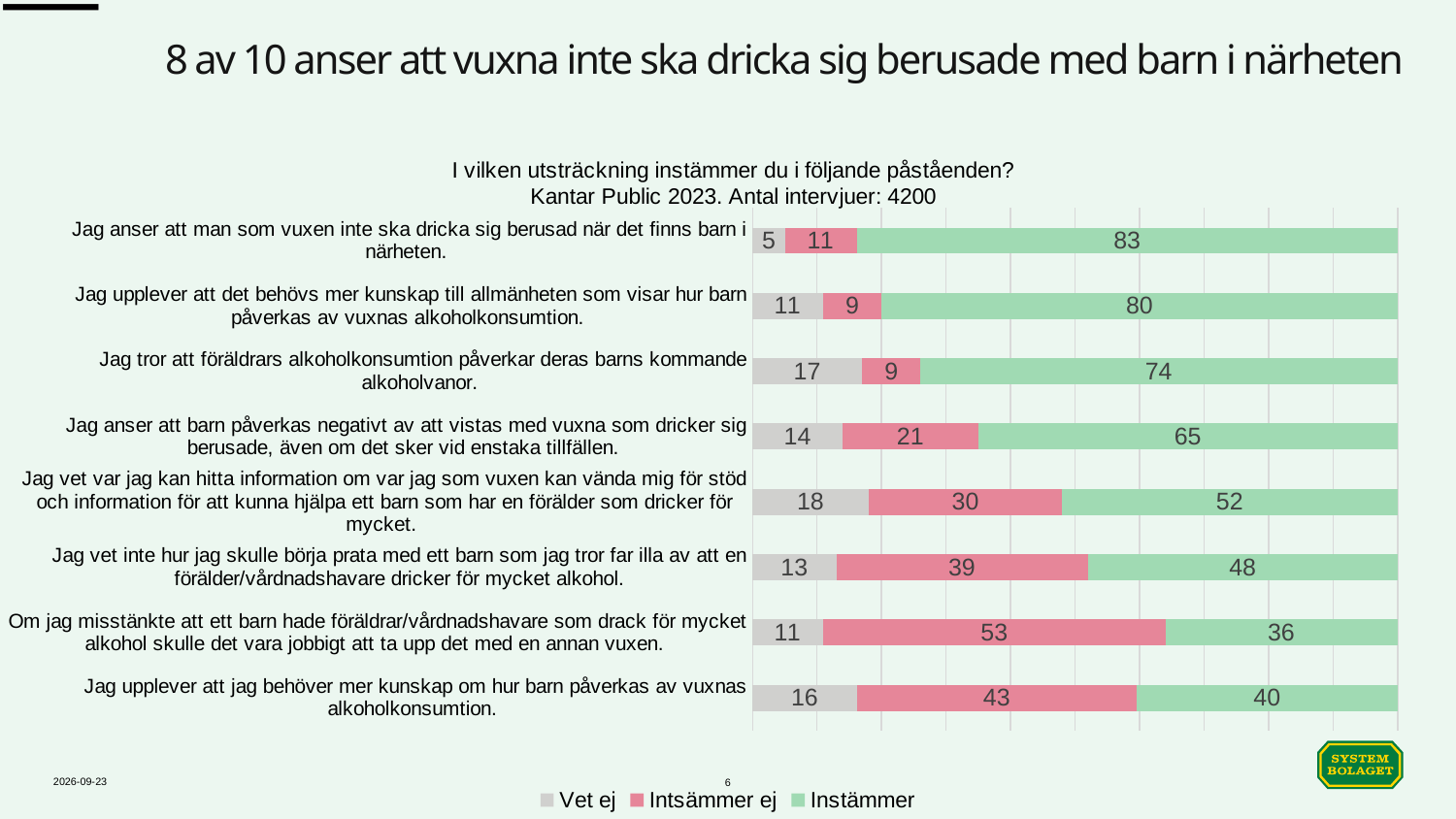
What is the 'Instämmer ej' value for the statement 'Om jag misstänkte att ett barn hade föräldrar/vårdnadshavare som drack för mycket alkohol skulle det vara jobbigt att ta upp det med en annan vuxen'? 53 What is the difference between the 'Instämmer' values for 'Jag upplever att det behövs mer kunskap till allmänheten som visar hur barn påverkas av vuxnas alkoholkonsumtion' and 'Jag tror att föräldrars alkoholkonsumtion påverkar deras barns kommande alkoholvanor'? 6 How many statements (categories) are plotted in the chart? 8 What is the total of the stacked bar for 'Jag vet inte hur jag skulle börja prata med ett barn som jag tror far illa av att en förälder/vårdnadshavare dricker för mycket alkohol'? 100 Which statement has the lowest 'Vet ej' value? Jag anser att man som vuxen inte ska dricka sig berusad när det finns barn i närheten. What is the 'Vet ej' value for the statement 'Jag vet var jag kan hitta information om var jag som vuxen kan vända mig för stöd och information för att kunna hjälpa ett barn som har en förälder som dricker för mycket'? 18 What kind of chart is shown on the slide? Stacked bar chart For the statement 'Jag upplever att jag behöver mer kunskap om hur barn påverkas av vuxnas alkoholkonsumtion', which is larger: 'Instämmer ej' or 'Instämmer'? Instämmer ej How many series does the legend list? 3 Which statement has the highest 'Instämmer' value? Jag anser att man som vuxen inte ska dricka sig berusad när det finns barn i närheten. What is the 'Instämmer' value for the statement 'Jag anser att man som vuxen inte ska dricka sig berusad när det finns barn i närheten'? 83 What is the survey question shown as the chart title? I vilken utsträckning instämmer du i följande påståenden?